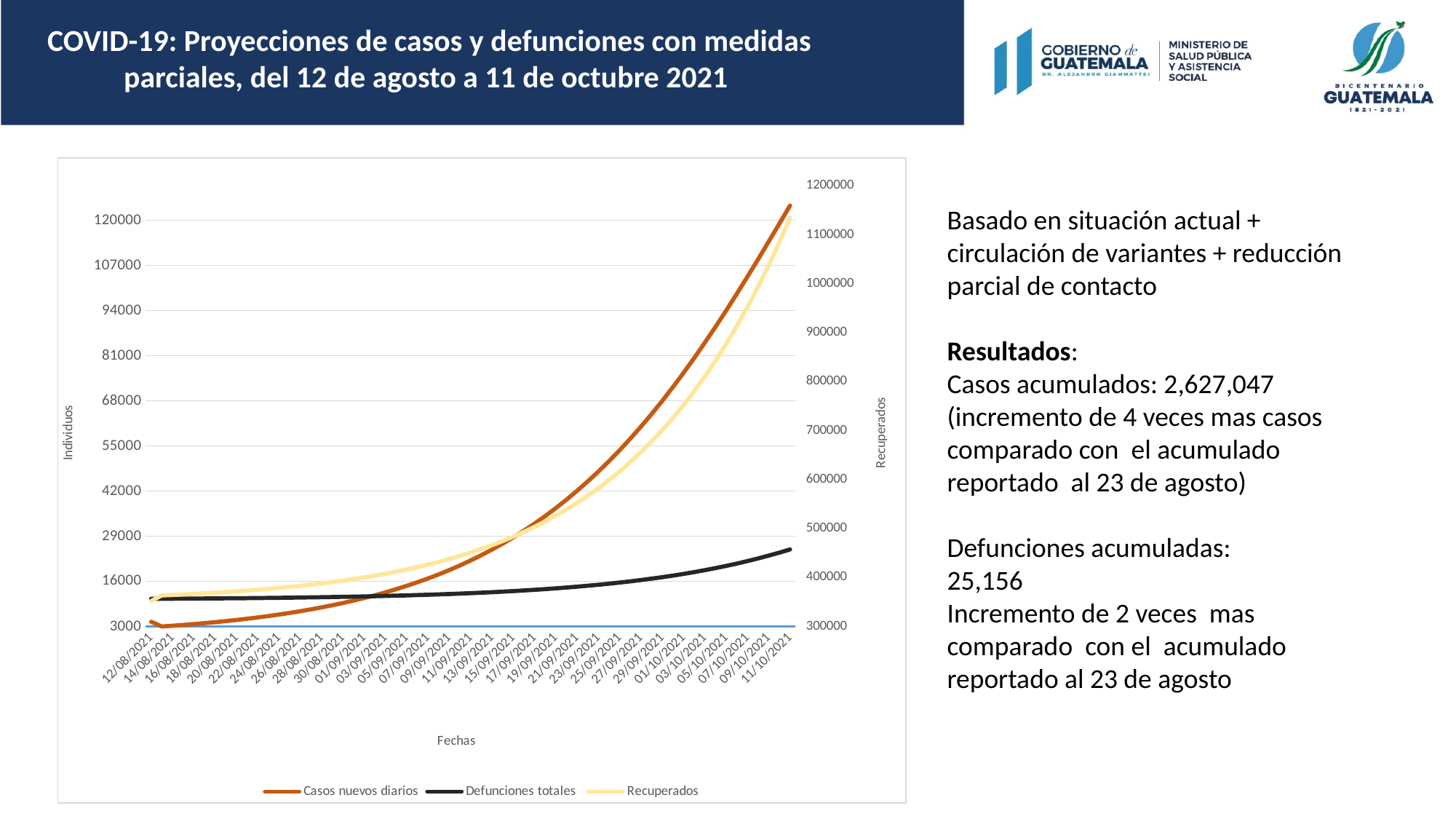
On 11/10/2021, which series has the larger value on the left axis: Casos nuevos diarios or Defunciones totales? Casos nuevos diarios Is the value for Casos nuevos diarios on 11/10/2021 greater or less than 120000? greater How many series does the chart legend list? 3 Is the value for Recuperados on 11/10/2021 greater or less than 1000000 on the right-hand axis? greater How many date labels are shown on the x axis of the chart? 31 Which series are listed in the chart legend? Casos nuevos diarios, Defunciones totales, Recuperados Does the Casos nuevos diarios series rise or fall from 12/08/2021 to 11/10/2021? Rise Is the value for Casos nuevos diarios on 12/08/2021 greater or less than 16000? less Does the Defunciones totales series rise or fall along the x axis? Rise What kind of chart is shown on the slide? Line chart What is the title of the horizontal axis of the chart? Fechas